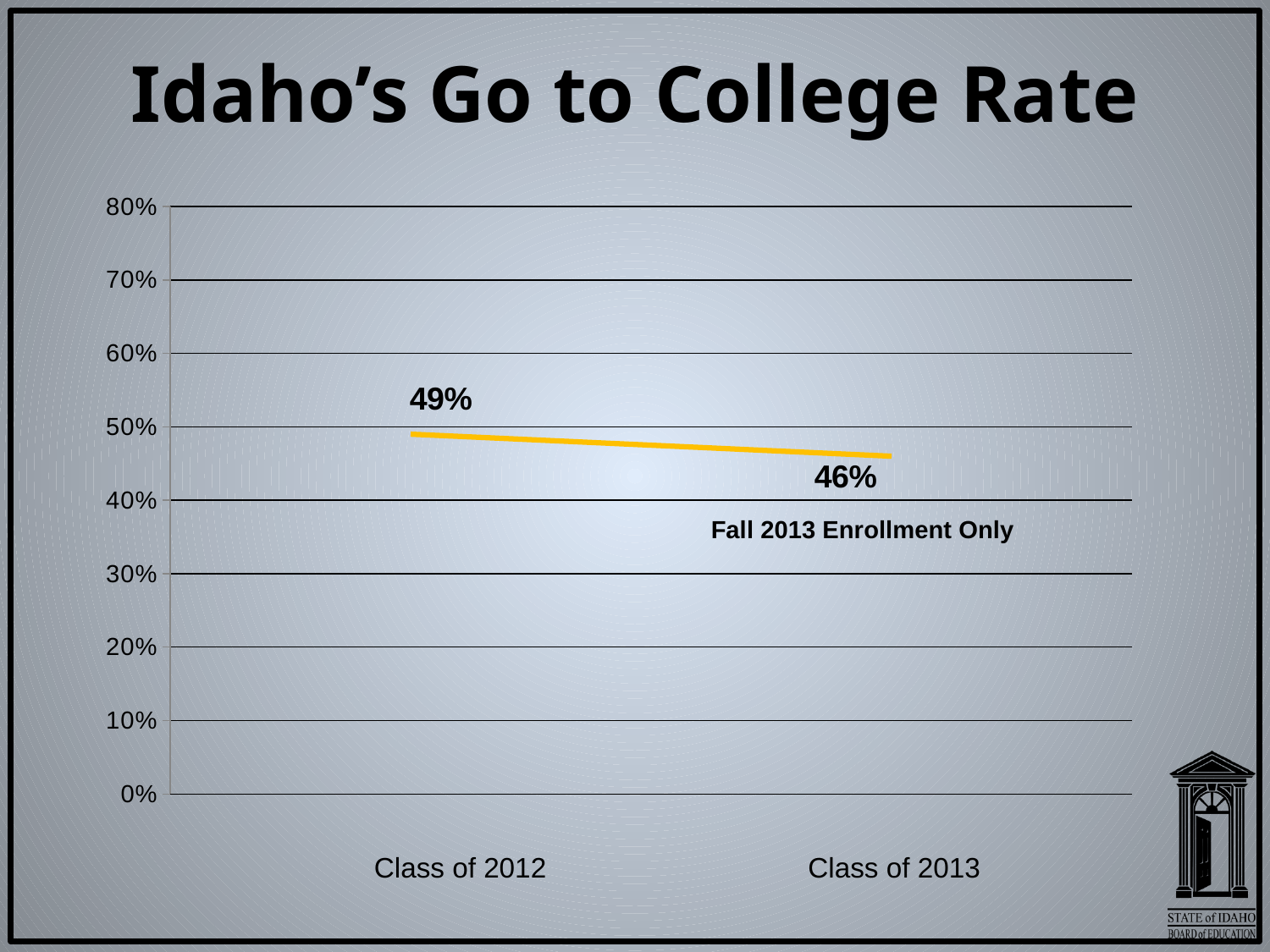
What is the title of the chart? Idaho's Go to College Rate What is the difference between the Class of 2012 rate and the Class of 2013 rate? 3% Is the value for the Class of 2013 greater or less than 50%? less What note is printed below the Class of 2013 data label? Fall 2013 Enrollment Only What is the go to college rate for the Class of 2012? 49% Which class has the higher go to college rate? Class of 2012 Which class has the lower go to college rate? Class of 2013 What kind of chart is shown on the slide? line chart Is the rate for the Class of 2012 larger or smaller than the rate for the Class of 2013? larger Does the go to college rate rise or fall from the Class of 2012 to the Class of 2013? fall How many classes are plotted on the chart? 2 What is the go to college rate for the Class of 2013? 46%